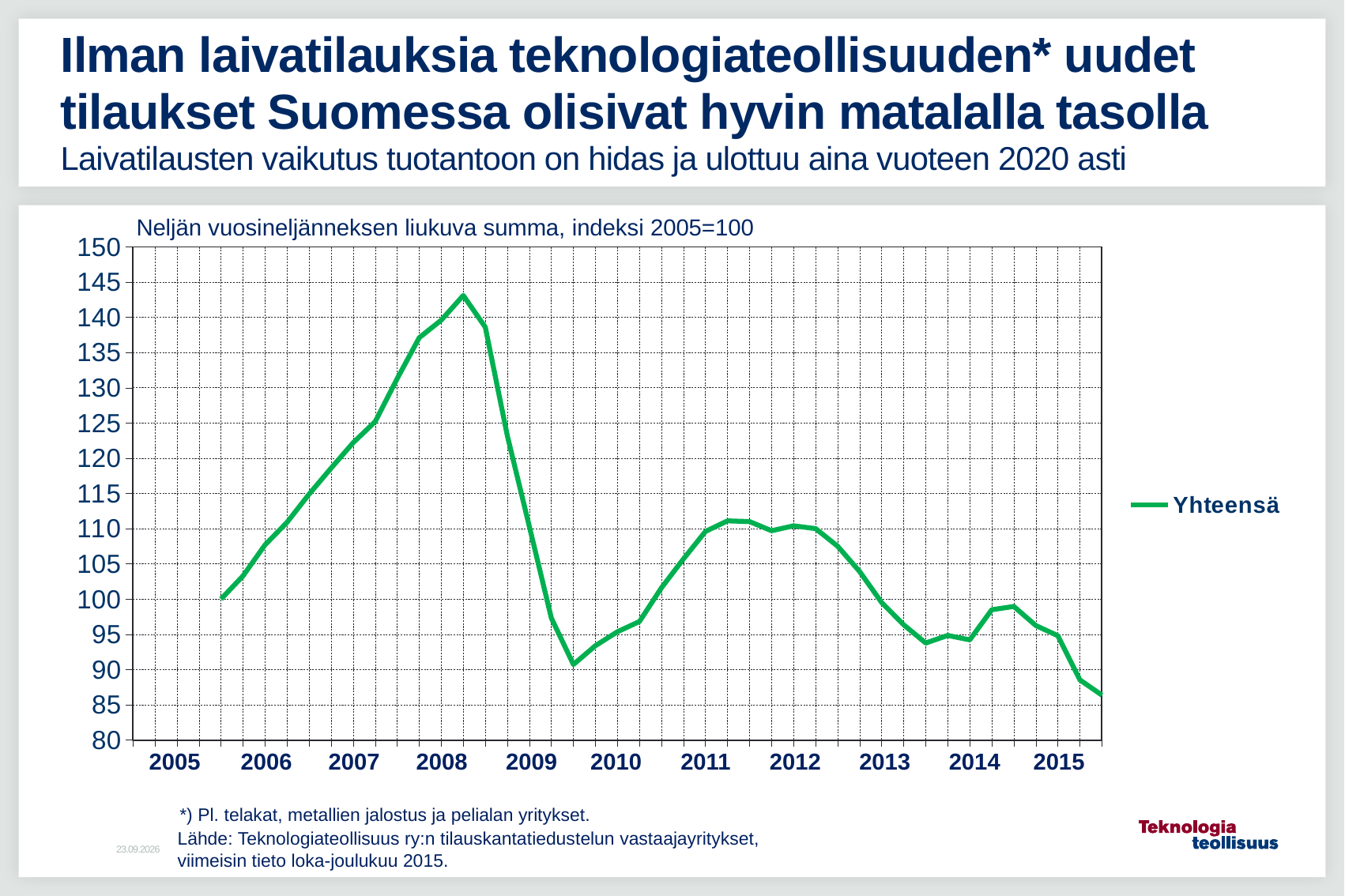
In which year does the Yhteensä line reach its highest point? 2008 How many series does the legend list? 1 What is the name of the series shown in the legend? Yhteensä What is the subtitle printed above the chart describing the index? Neljän vuosineljänneksen liukuva summa, indeksi 2005=100 What kind of chart is shown on the slide? line chart Is the lowest value of the Yhteensä line in 2009 greater or less than 95? less Does the Yhteensä line rise or fall between 2008 and 2009? falls In which year does the Yhteensä line reach its lowest point? 2015 Is the peak value of the Yhteensä line in 2008 greater or less than 140? greater Does the Yhteensä line rise or fall between 2005 and 2008? rises Is the value of the Yhteensä line at the end of 2015 greater or less than 90? less What is the index value of the Yhteensä line at its starting point in 2005? 100